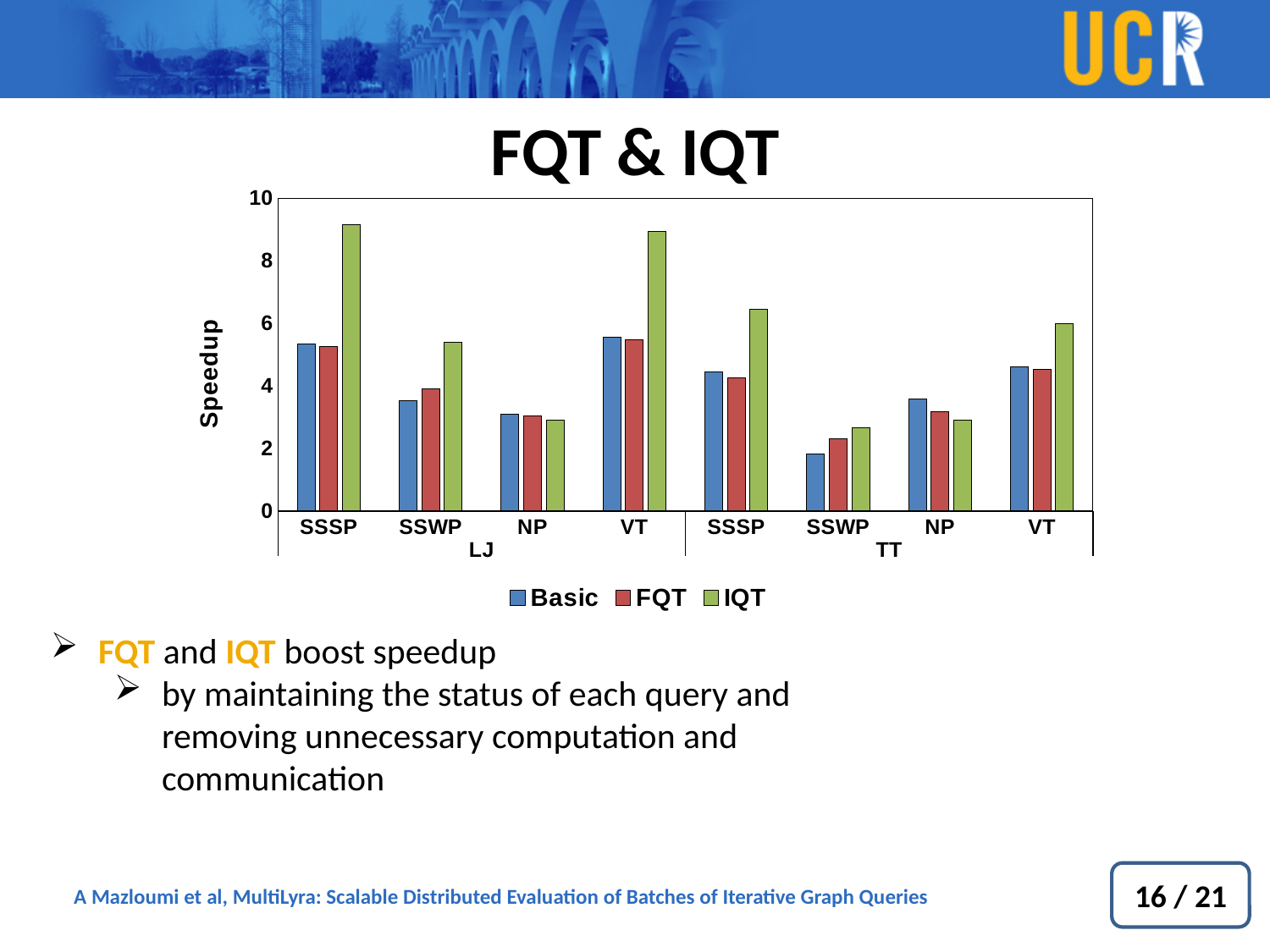
Is the IQT value for VT on TT greater or less than 4? greater How many category groups are plotted along the x axis? 8 For which category does the IQT series reach its highest speedup? SSSP (LJ) What is the title of the chart? FQT & IQT Is the IQT value for SSSP on LJ greater or less than 8? greater How many series does the legend list? 3 For NP on TT, which is larger: the Basic speedup or the IQT speedup? Basic For which category is the Basic speedup lowest? SSWP (TT) Is the Basic value for SSWP on TT greater or less than 2? less What is the label of the y axis? Speedup For SSWP on LJ, which is larger: the FQT speedup or the IQT speedup? IQT What kind of chart is shown on the slide? bar chart